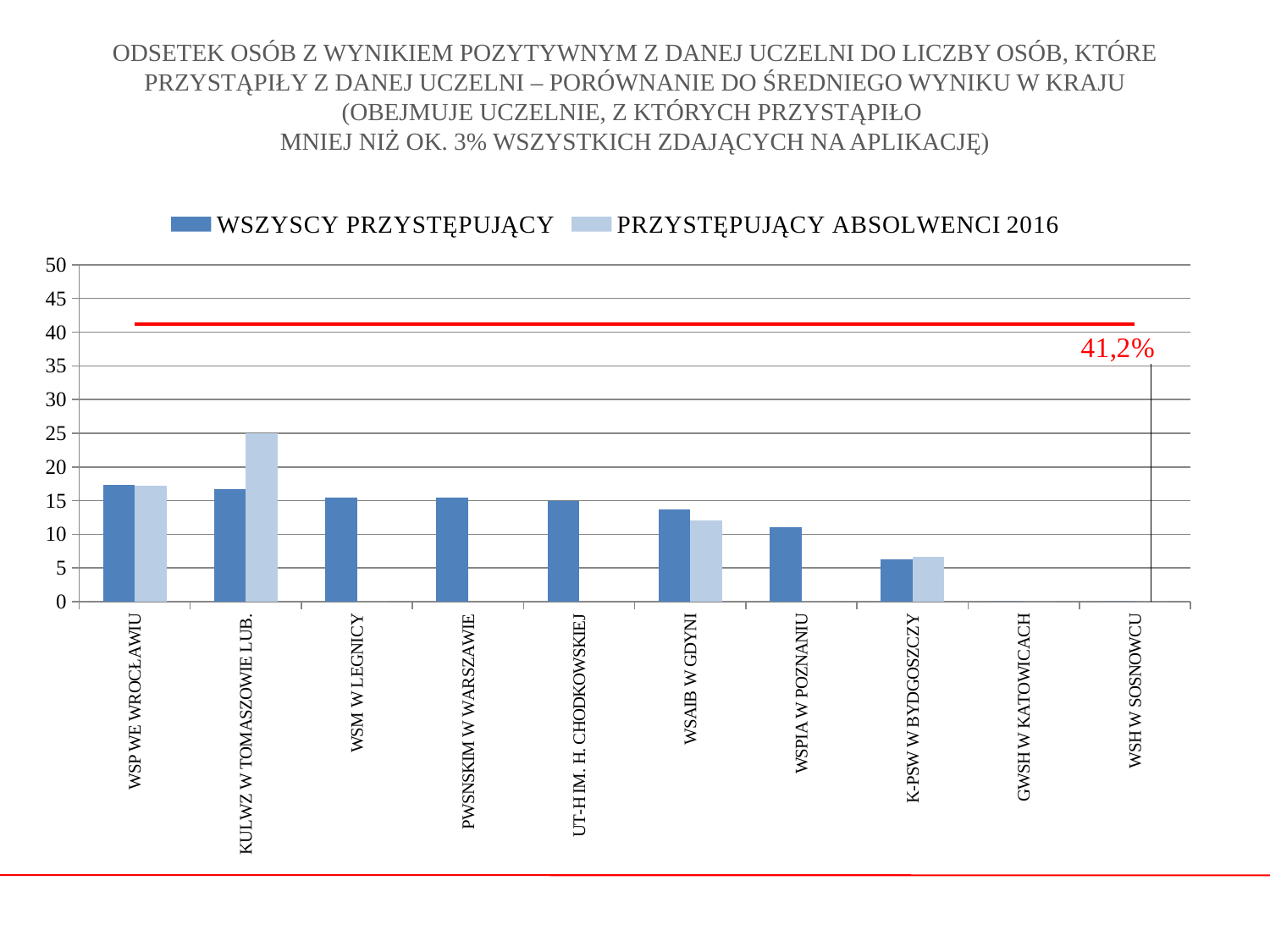
How many series does the legend list? 2 How many universities (categories) are shown on the x axis? 10 Which has the larger WSZYSCY PRZYSTĘPUJĄCY value: WSP WE WROCŁAWIU or WSPIA W POZNANIU? WSP WE WROCŁAWIU For WSAIB W GDYNI, which series has the larger value: WSZYSCY PRZYSTĘPUJĄCY or PRZYSTĘPUJĄCY ABSOLWENCI 2016? WSZYSCY PRZYSTĘPUJĄCY Which university has the highest value for the PRZYSTĘPUJĄCY ABSOLWENCI 2016 series? KULWZ W TOMASZOWIE LUB. Is the WSZYSCY PRZYSTĘPUJĄCY value for K-PSW W BYDGOSZCZY greater or less than 10? less What value is labelled on the red horizontal reference line in the chart? 41,2% Is the WSZYSCY PRZYSTĘPUJĄCY value for WSPIA W POZNANIU greater or less than 15? less Is the PRZYSTĘPUJĄCY ABSOLWENCI 2016 value for KULWZ W TOMASZOWIE LUB. greater or less than 20? greater What kind of chart is shown on the slide? bar chart What are the two series names listed in the chart legend? WSZYSCY PRZYSTĘPUJĄCY and PRZYSTĘPUJĄCY ABSOLWENCI 2016